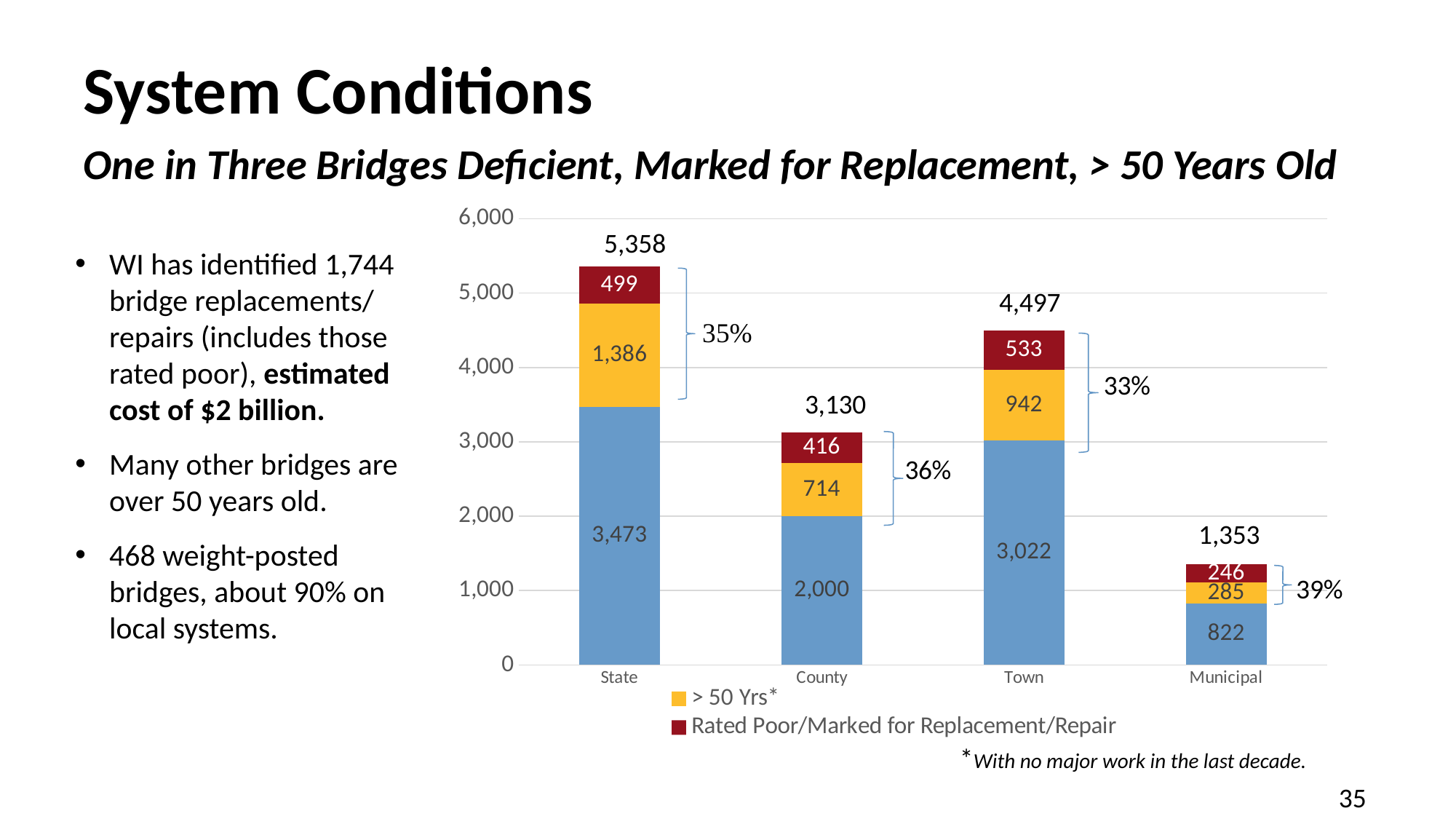
What is the '> 50 Yrs*' value for Town? 942 What percentage is shown next to the bracket beside the Municipal bar? 39% Which category has the highest total bar? State How many series does the chart's legend list? 2 What kind of chart is shown on the slide? Stacked bar chart What is the 'Rated Poor/Marked for Replacement/Repair' value for County? 416 Which category has the lowest total bar? Municipal What is the difference between the 'Rated Poor/Marked for Replacement/Repair' values for Town and State? 34 How many categories are shown on the x axis of the chart? 4 Which is larger, the '> 50 Yrs*' value for State or for County? State What is the total value printed above the State bar? 5,358 What is the total value printed above the Municipal bar? 1,353